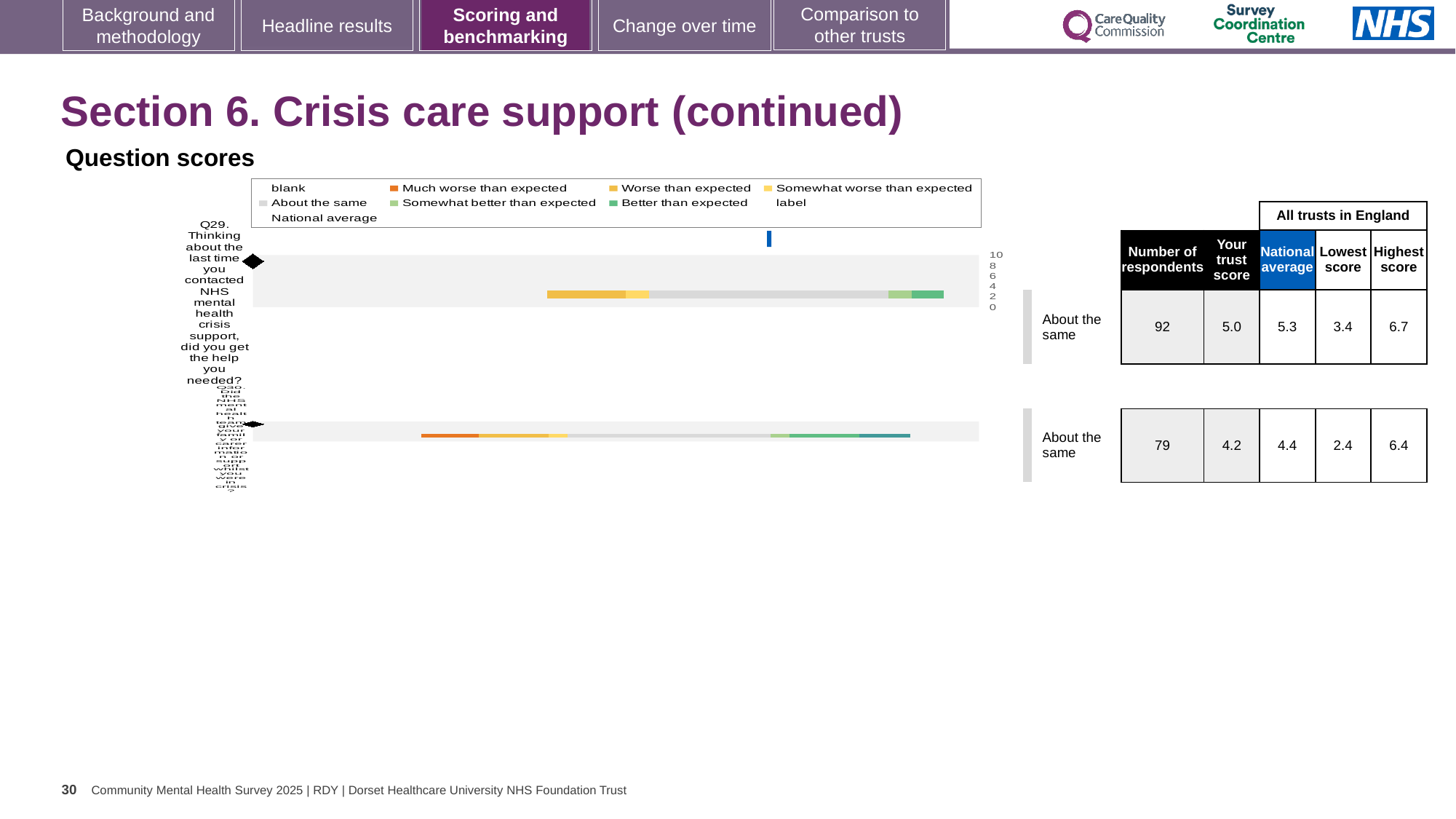
What is the difference between the highest score and the lowest score shown for Q30? 4.0 For Q29, which is larger: the trust's score or the national average? National average What benchmark category is shown next to the chart for Q29? About the same What is the 'Your trust score' value shown for the second question (Q30)? 4.2 What is the national average score shown for Q29? 5.3 How many questions are plotted in the chart? 2 What kind of chart is used to show the question scores? Bar chart What is the difference between the highest score and the lowest score shown for Q29? 3.3 What is the 'Your trust score' value shown for Q29 (Thinking about the last time you contacted NHS mental health crisis support, did you get the help you needed?)? 5.0 Which question has more respondents, Q29 or Q30? Q29 What is the highest score among all trusts in England shown for Q30? 6.4 How many respondents are shown for Q29? 92